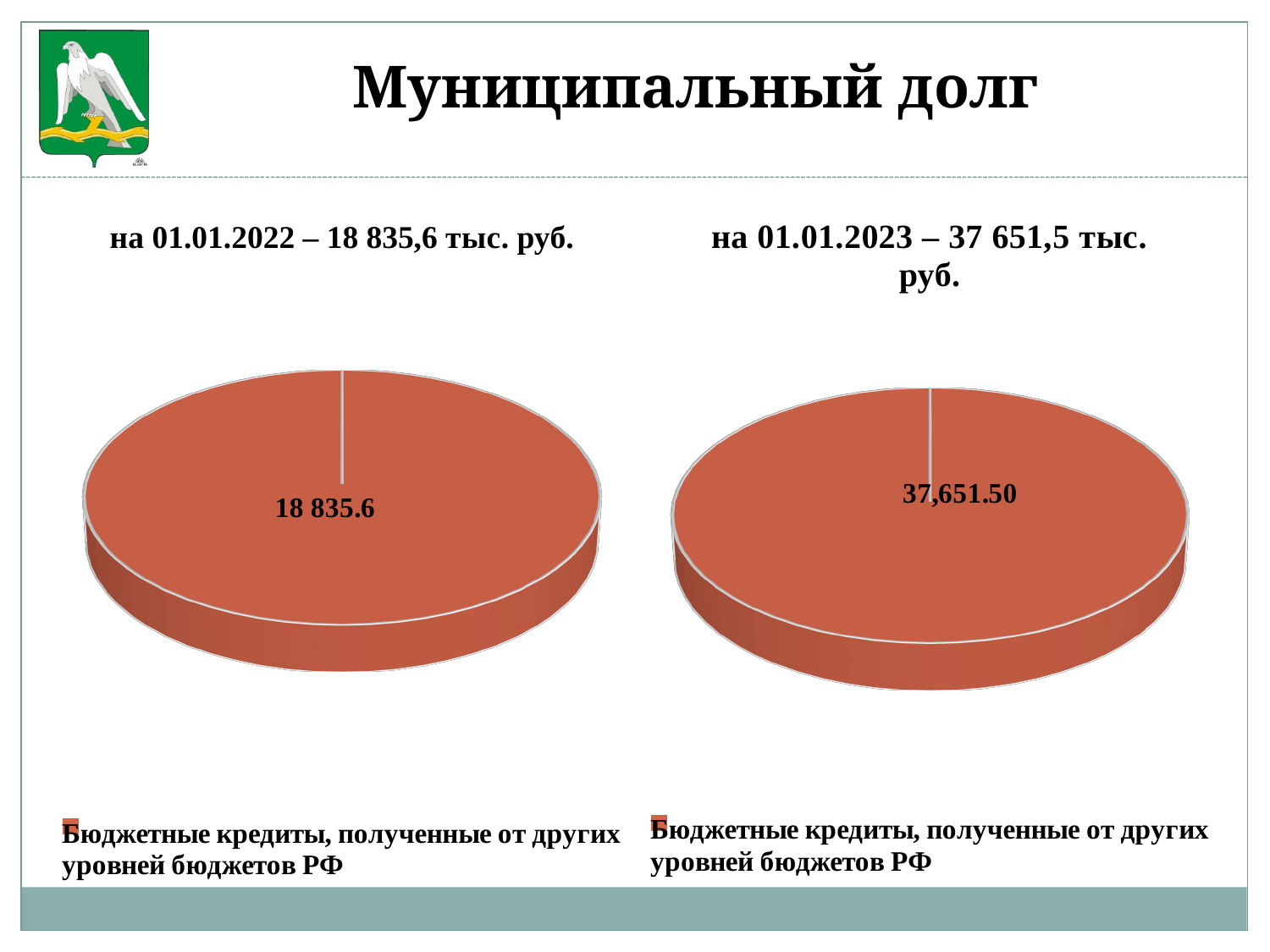
What is the legend entry of the right pie chart (на 01.01.2023)? Бюджетные кредиты, полученные от других уровней бюджетов РФ How many entries does the legend of the left pie chart (на 01.01.2022) list? 1 What is the title of the slide containing the two pie charts? Муниципальный долг What is the difference between the value in the right pie chart (37,651.50) and the value in the left pie chart (18 835.6)? 18 815.9 In the right pie chart (на 01.01.2023), what value is printed on the slice? 37,651.50 Which is larger: the value in the left pie chart (на 01.01.2022) or the value in the right pie chart (на 01.01.2023)? The right pie chart (на 01.01.2023) What kind of chart is the left chart (на 01.01.2022)? Pie chart What share of the right pie chart (на 01.01.2023) does the slice 'Бюджетные кредиты, полученные от других уровней бюджетов РФ' take? 100% In the left pie chart (на 01.01.2022), what value is printed on the slice? 18 835.6 How many slices does the left pie chart (на 01.01.2022) have? 1 How many slices does the right pie chart (на 01.01.2023) have? 1 What kind of chart is the right chart (на 01.01.2023)? Pie chart